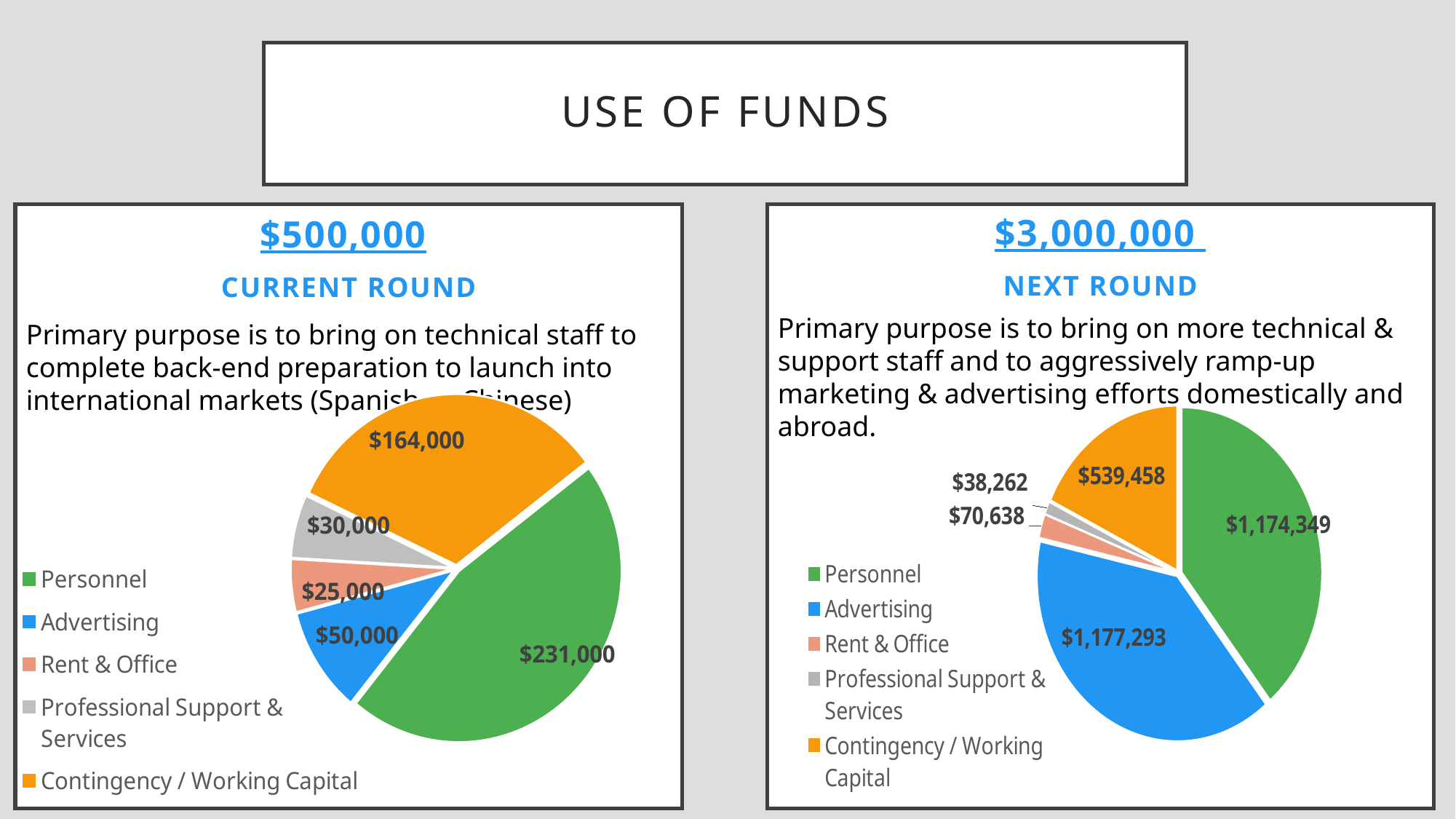
In the Next Round chart, what is the value for Professional Support & Services? $38,262 What type of chart is used in the Current Round panel? Pie chart In the Current Round chart, which category has the largest slice? Personnel In the Next Round chart, what is the difference between Advertising and Personnel? $2,944 In the Next Round chart, what is the value for Advertising? $1,177,293 How many categories does the legend of the Next Round chart list? 5 In the Current Round chart, which category has the smallest slice? Rent & Office In the Current Round chart, what is the difference between Advertising and Rent & Office? $25,000 In the Current Round chart, what is the value for Contingency / Working Capital? $164,000 In the Next Round chart, which colour represents Contingency / Working Capital? Orange In the Current Round chart, what is the value for Personnel? $231,000 In the Current Round chart, what share of the $500,000 total does Personnel represent? 46.2%